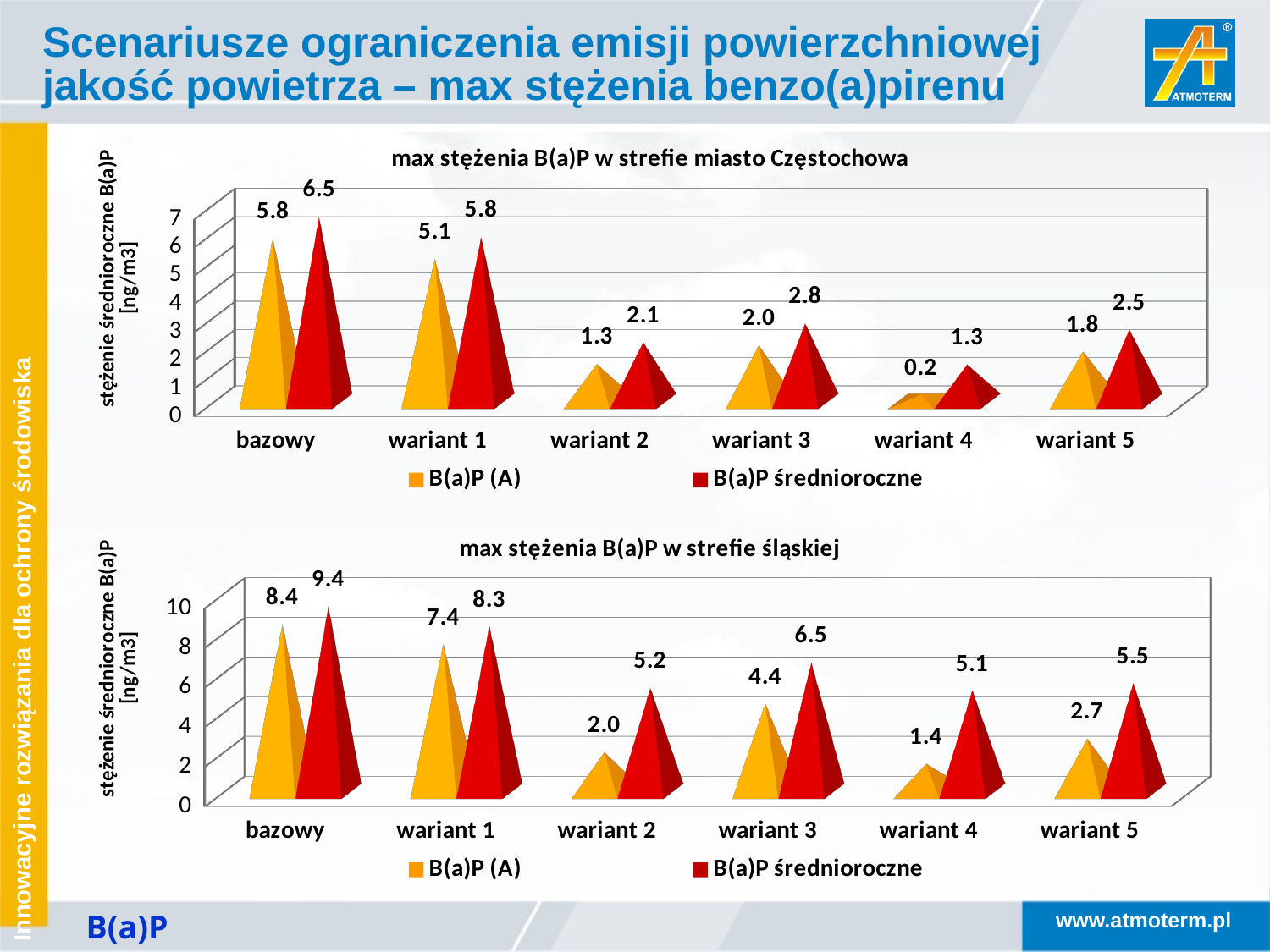
In the chart 'max stężenia B(a)P w strefie śląskiej', what is the difference between the B(a)P średnioroczne values for bazowy and wariant 1? 1.1 In the chart 'max stężenia B(a)P w strefie miasto Częstochowa', what is the difference between the B(a)P średnioroczne and B(a)P (A) values for wariant 1? 0.7 In the chart 'max stężenia B(a)P w strefie miasto Częstochowa', what is the value of B(a)P średnioroczne for bazowy? 6.5 In the chart 'max stężenia B(a)P w strefie śląskiej', what is the value of B(a)P (A) for wariant 3? 4.4 In the chart 'max stężenia B(a)P w strefie śląskiej', which category has the highest B(a)P średnioroczne value? bazowy In the chart 'max stężenia B(a)P w strefie śląskiej', which is larger: the B(a)P (A) value for wariant 2 or for wariant 4? wariant 2 In the chart 'max stężenia B(a)P w strefie miasto Częstochowa', how many categories are shown on the x axis? 6 How many series does the legend of the chart 'max stężenia B(a)P w strefie śląskiej' list? 2 What kind of chart is 'max stężenia B(a)P w strefie miasto Częstochowa'? bar chart In the chart 'max stężenia B(a)P w strefie śląskiej', what is the value of B(a)P średnioroczne for wariant 5? 5.5 In the chart 'max stężenia B(a)P w strefie miasto Częstochowa', which category has the lowest B(a)P (A) value? wariant 4 In the chart 'max stężenia B(a)P w strefie miasto Częstochowa', what is the value of B(a)P (A) for wariant 4? 0.2